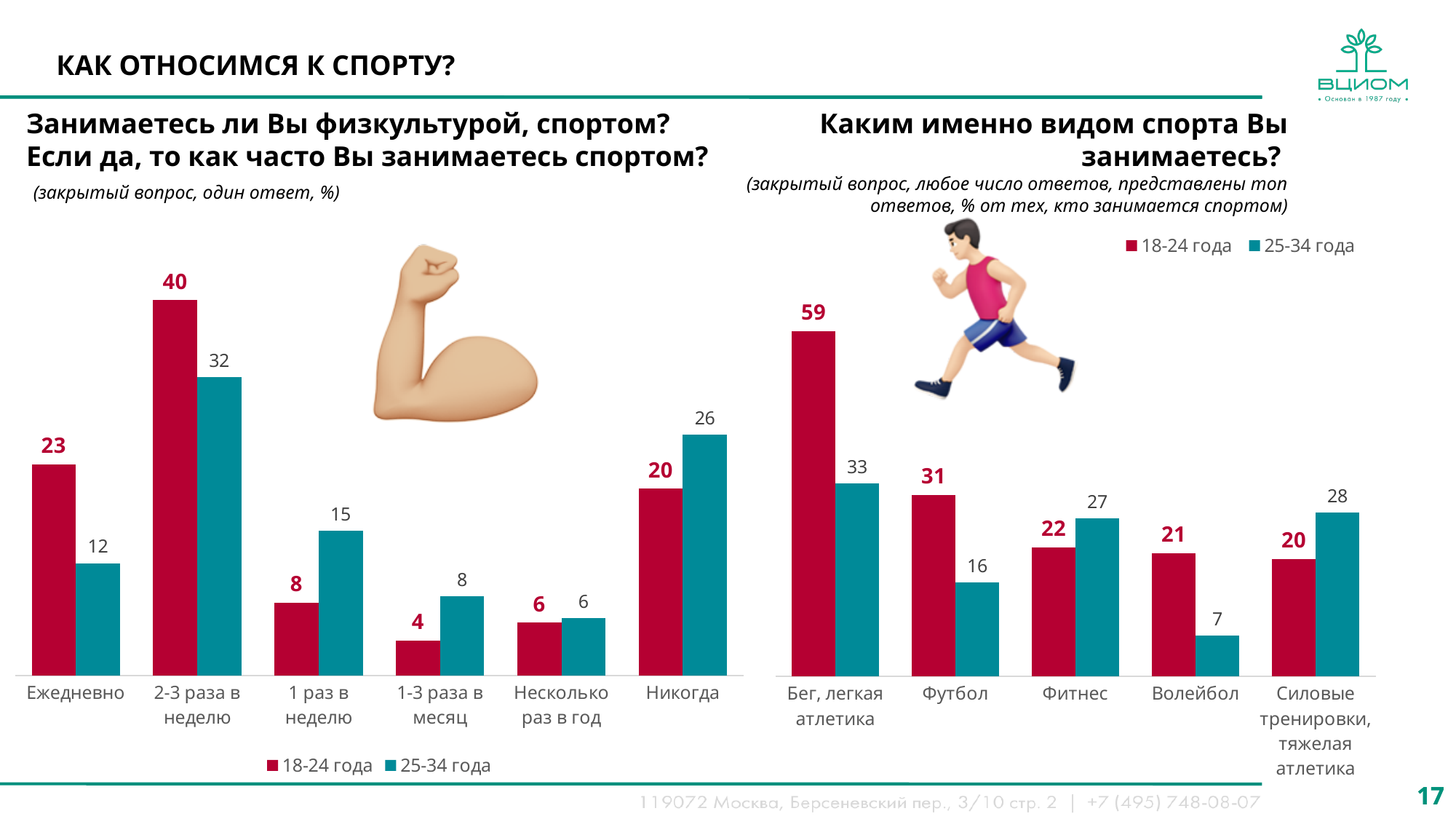
On the left chart, what is the difference between the 18-24 года and 25-34 года values for 'Ежедневно'? 11 On the left chart, what is the value for '2-3 раза в неделю' for the 18-24 года series? 40 On the right chart, what is the value for 'Футбол' for the 25-34 года series? 16 On the right chart, which category has the highest value for the 18-24 года series? Бег, легкая атлетика On the left chart, what is the value for 'Никогда' for the 25-34 года series? 26 On the right chart, what is the difference between the 18-24 года and 25-34 года values for 'Бег, легкая атлетика'? 26 On the left chart, how many categories are shown on the x axis? 6 On the right chart, which is larger for 'Фитнес': the 18-24 года value or the 25-34 года value? 25-34 года On the left chart, which category has the highest value for the 25-34 года series? 2-3 раза в неделю On the right chart, which category has the lowest value for the 25-34 года series? Волейбол On the left chart, which category has the lowest value for the 18-24 года series? 1-3 раза в месяц How many series does the legend of the right chart list? 2